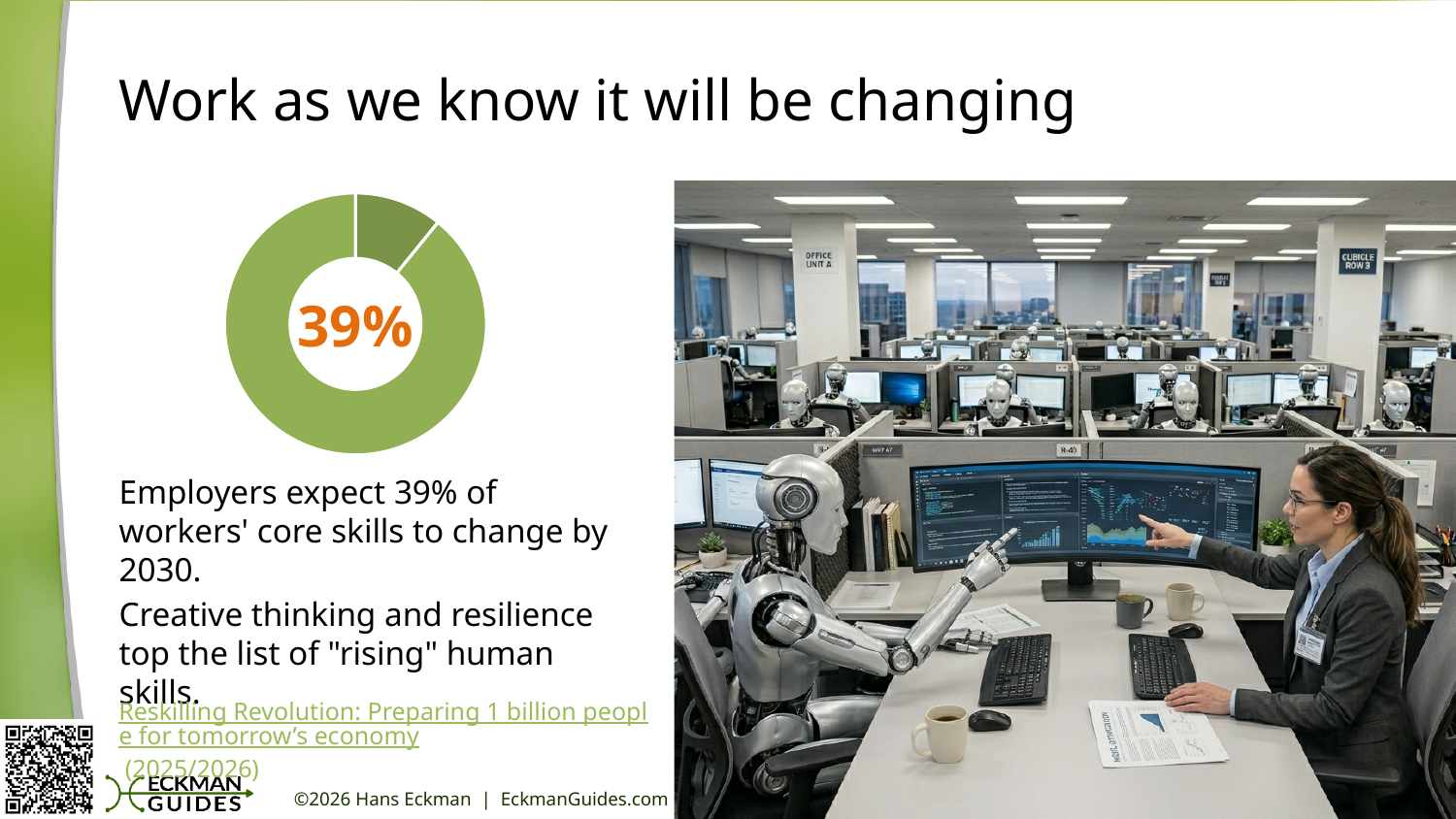
Is the value printed in the center of the donut chart greater or less than 50%? less According to the slide, what does the 39% in the donut chart represent? The share of workers' core skills employers expect to change by 2030 What value is printed in the center of the donut chart? 39% How many segments does the donut chart have? 2 What colour is the text of the percentage shown in the center of the donut chart? Orange What kind of chart is shown on the left of the slide? Donut (pie) chart By what year do employers expect 39% of workers' core skills to change, according to the slide? 2030 Which segment of the donut chart is larger, the dark green one or the light green one? The light green one